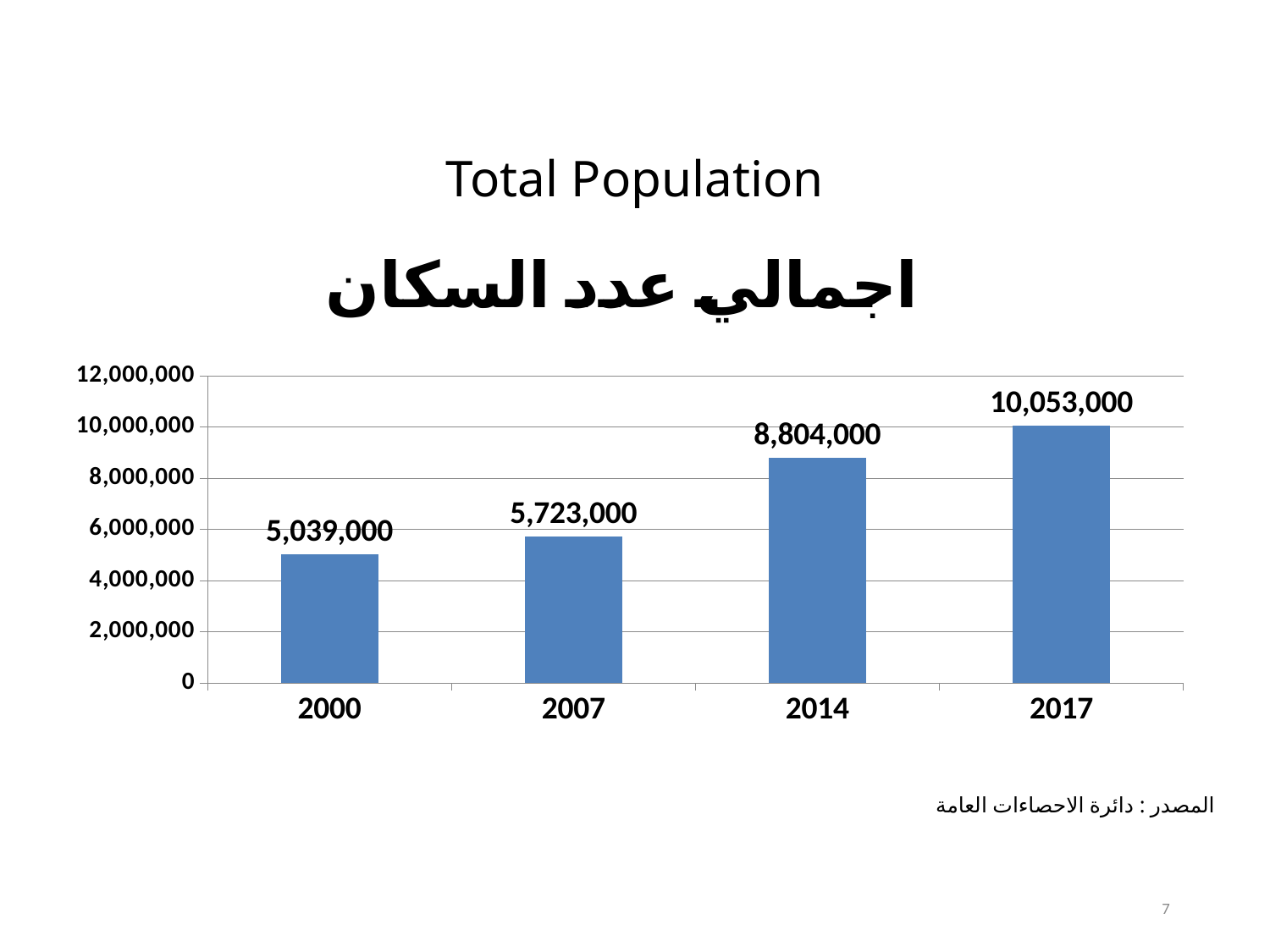
How many years are shown on the x axis of the chart? 4 What kind of chart is shown on the slide? bar chart Which year has the lowest total population? 2000 What is the total population shown for 2017? 10,053,000 Which year has the highest total population? 2017 What is the total population shown for 2007? 5,723,000 What is the difference in total population between 2007 and 2000? 684,000 What is the total population shown for 2014? 8,804,000 Is the value for 2017 greater or less than 10,000,000? greater Which year has a larger total population, 2007 or 2014? 2014 What is the total population shown for 2000? 5,039,000 What is the difference in total population between 2017 and 2014? 1,249,000